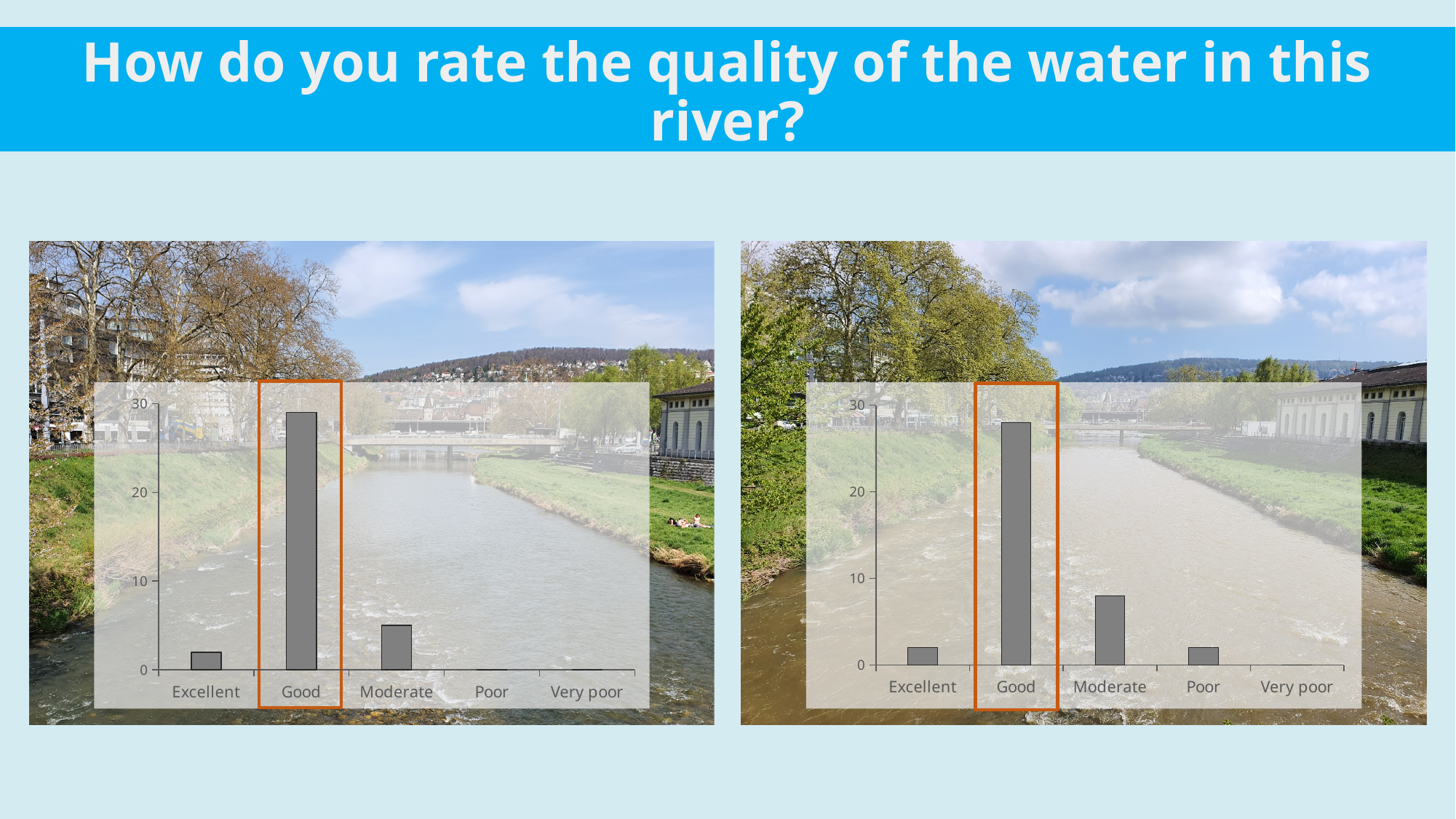
What is the highest tick value shown on the y axis of the left chart? 30 In the left chart, which category has the highest bar? Good In the right chart, which category has the highest bar? Good In the left chart, is the value for Good greater or less than 20? greater In the right chart, is the value for Moderate greater or less than 10? less Which category is outlined with an orange box in both charts? Good What kind of chart is the right chart? bar chart In the right chart, which is larger, the value for Moderate or the value for Excellent? Moderate In the right chart, is the value for Good greater or less than 20? greater How many categories are shown on the x axis of the left chart? 5 In the left chart, which is larger, the value for Good or the value for Moderate? Good